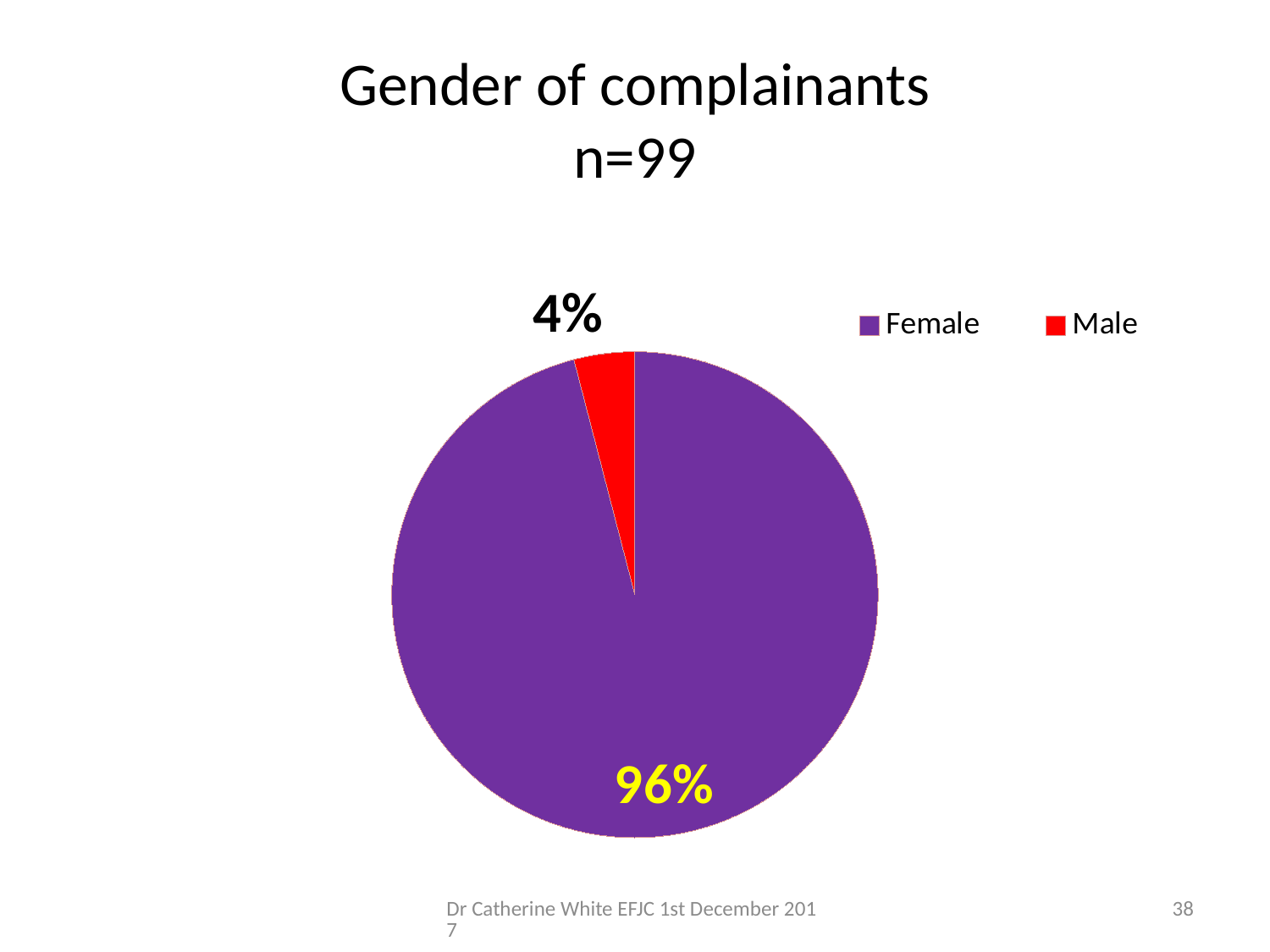
What colour represents Male in the pie chart? red What share of complainants are Female? 96% What type of chart is shown on the slide? pie chart Which gender has the smallest share of complainants? Male How many entries does the legend list? 2 What is the difference in percentage points between the Female and Male shares? 92 Which is larger, the Female share or the Male share? Female Is the Female share greater or less than 50%? greater What is the title of the chart? Gender of complainants n=99 Which gender has the largest share of complainants? Female How many categories does the pie chart show? 2 What share of complainants are Male? 4%